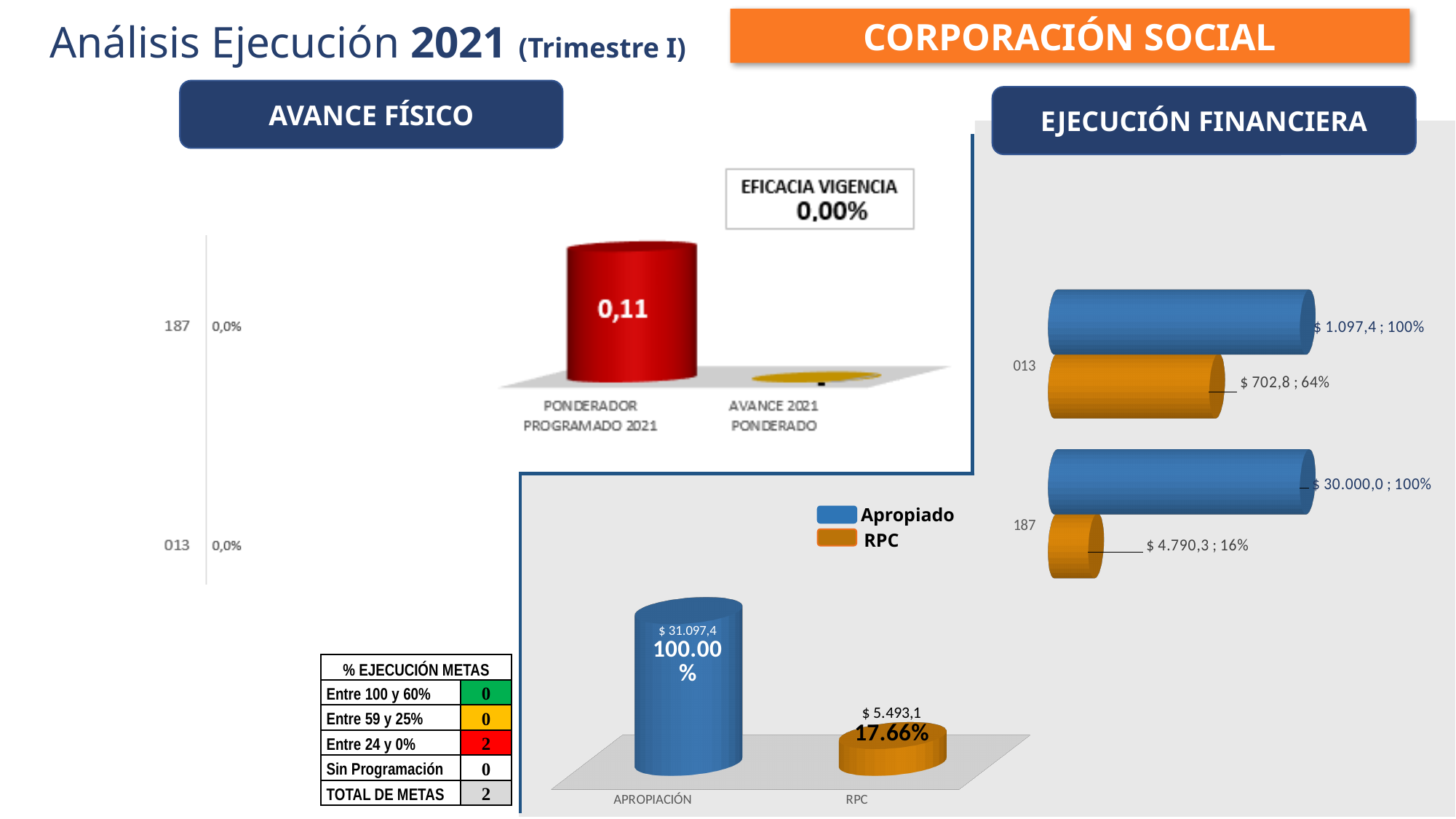
In the chart under AVANCE FÍSICO with PONDERADOR PROGRAMADO 2021 and AVANCE 2021 PONDERADO, what is the value for PONDERADOR PROGRAMADO 2021? 0,11 In the horizontal bar chart on the right under EJECUCIÓN FINANCIERA, what is the Apropiado value for category 187? $ 30.000,0 In the bottom chart with APROPIACIÓN and RPC, which category has the higher value? APROPIACIÓN In the horizontal bar chart on the right under EJECUCIÓN FINANCIERA, which category has the larger Apropiado value, 013 or 187? 187 In the bottom chart with APROPIACIÓN and RPC, what percentage is shown for RPC? 17.66% In the horizontal bar chart on the right under EJECUCIÓN FINANCIERA, what is the RPC value for category 013? $ 702,8 In the leftmost chart with categories 187 and 013, what value is shown for category 187? 0,0% In the bottom chart with APROPIACIÓN and RPC, what is the value shown for APROPIACIÓN? $ 31.097,4 In the horizontal bar chart on the right under EJECUCIÓN FINANCIERA, what colour are the RPC bars? Orange In the horizontal bar chart on the right under EJECUCIÓN FINANCIERA, how many series does the legend list? 2 In the horizontal bar chart on the right under EJECUCIÓN FINANCIERA, what percentage is shown next to the RPC bar for category 187? 16% In the chart under AVANCE FÍSICO with PONDERADOR PROGRAMADO 2021 and AVANCE 2021 PONDERADO, how many categories are shown? 2